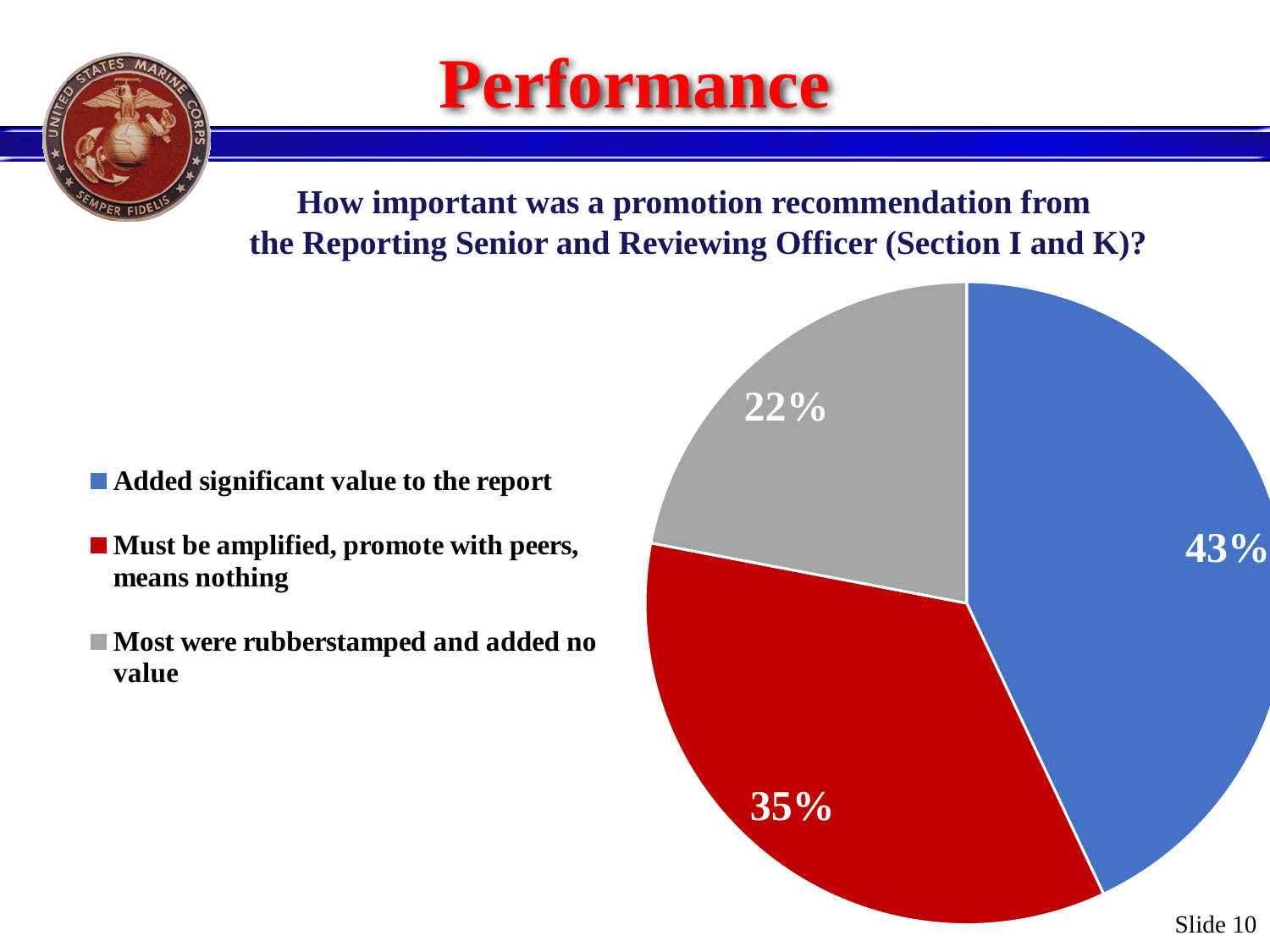
What is the difference in percentage points between 'Added significant value to the report' and 'Must be amplified, promote with peers, means nothing'? 8 How many slices does the pie chart have? 3 How many entries does the legend list? 3 What share of the pie is 'Most were rubberstamped and added no value'? 22% What share of the pie is 'Added significant value to the report'? 43% Which category has the largest slice of the pie? Added significant value to the report What colour is the slice for 'Most were rubberstamped and added no value'? grey What is the difference in percentage points between 'Added significant value to the report' and 'Most were rubberstamped and added no value'? 21 What share of the pie is 'Must be amplified, promote with peers, means nothing'? 35% Which is larger: the slice for 'Must be amplified, promote with peers, means nothing' or the slice for 'Most were rubberstamped and added no value'? Must be amplified, promote with peers, means nothing Which category has the smallest slice of the pie? Most were rubberstamped and added no value What kind of chart is shown on the slide? pie chart